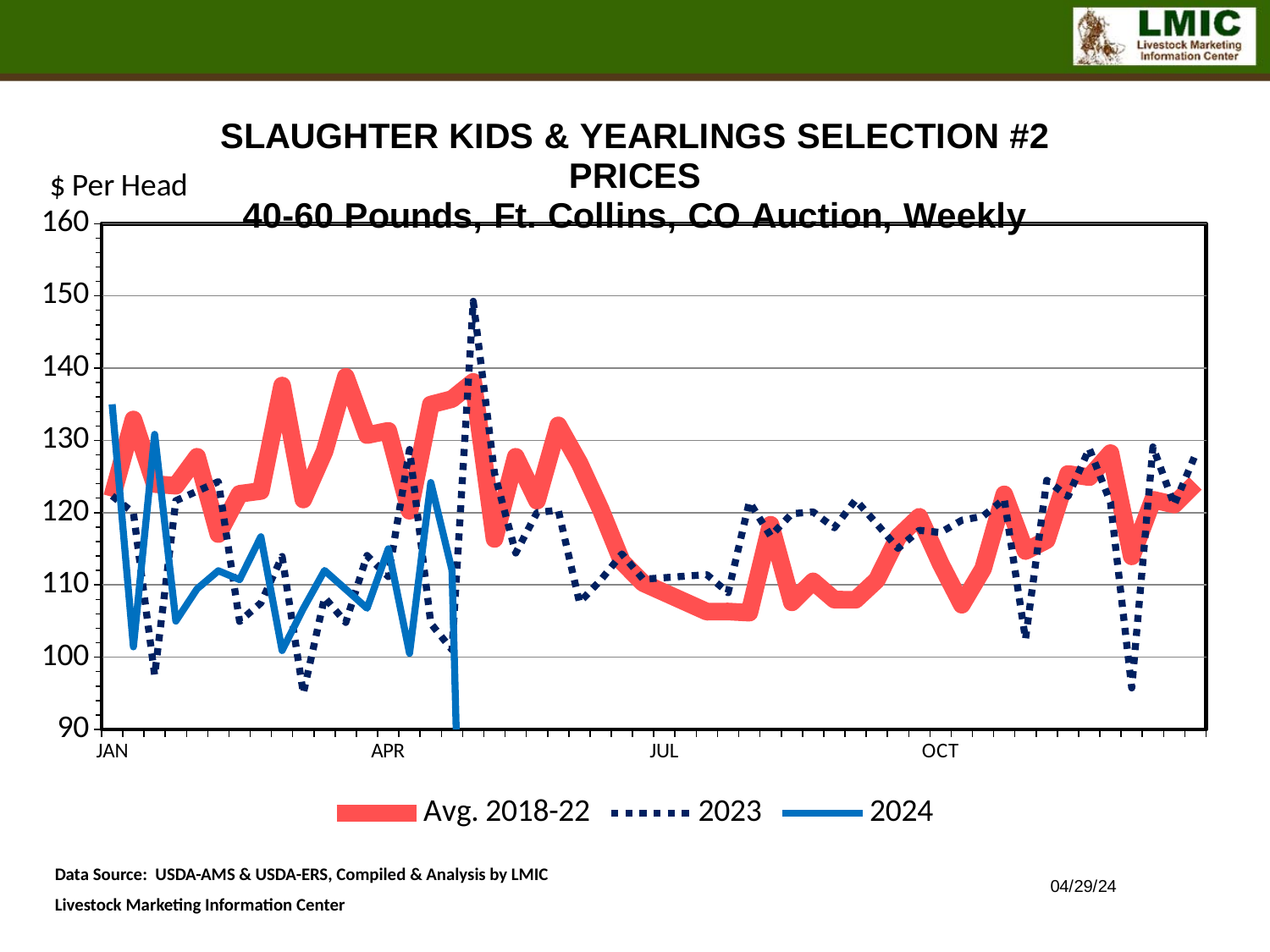
Is the highest value of the 2023 series (its peak in late April/early May) greater or less than 140? greater How many series does the legend list? 3 Does the Avg. 2018-22 series rise or fall between early May and August? fall Is the value of the 2024 series at the start of January greater or less than 130? greater What kind of chart is shown on the slide? line chart What unit is shown on the vertical axis label? $ Per Head Is the lowest value of the 2023 series (its dip in early December) greater or less than 100? less How many month labels are shown along the x axis? 4 Which series has the highest single value on the chart? 2023 What are the three series named in the legend? Avg. 2018-22, 2023, 2024 Which series has the lowest single value on the chart? 2023